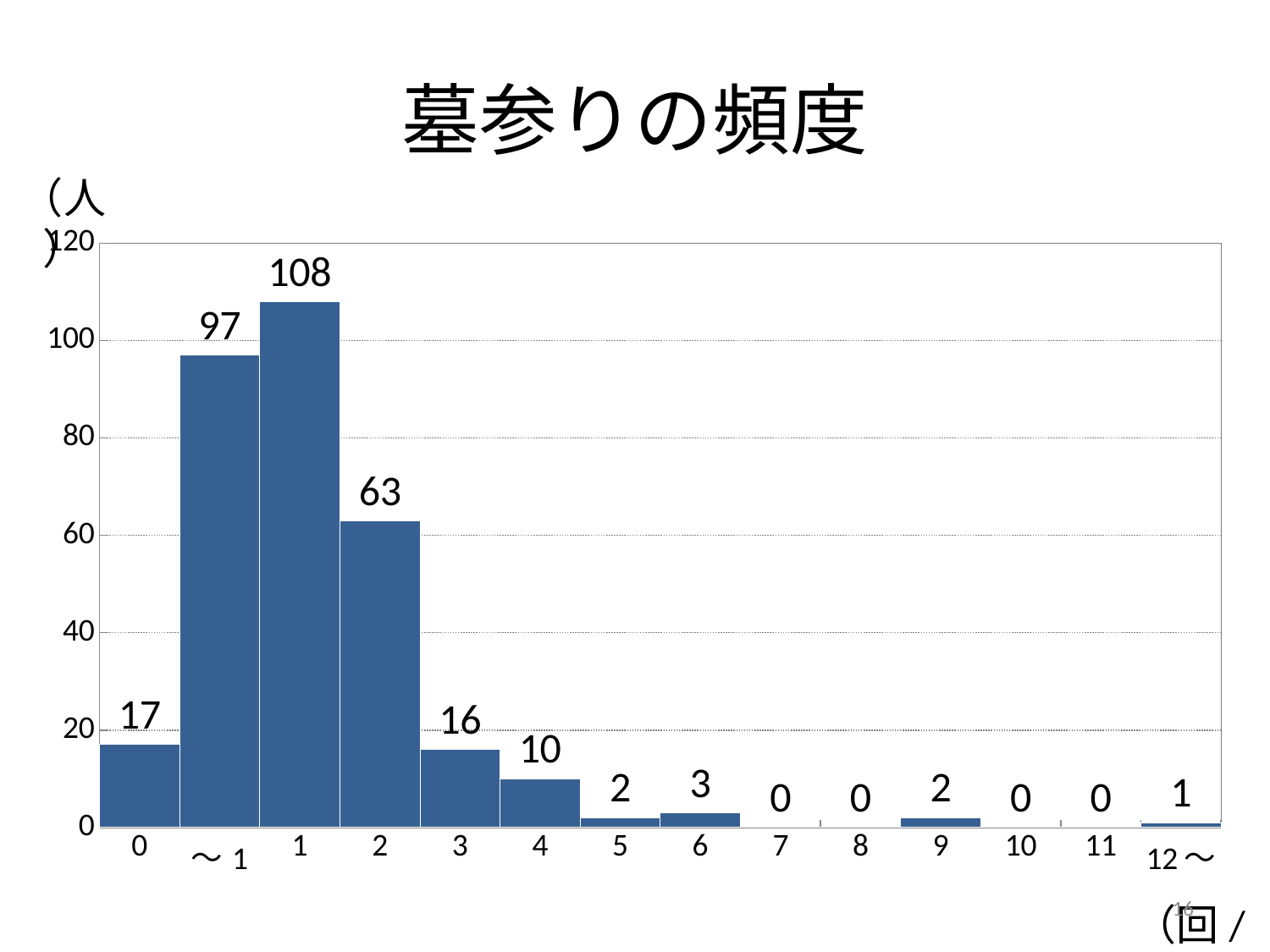
Which is larger, the value for category 3 or the value for category 4? 3 What is the value for category 1? 108 What is the value for category 0? 17 What is the difference between the values for category 1 and category 2? 45 What is the title of the chart? 墓参りの頻度 How many categories are shown on the x axis? 14 Is the value for category 2 greater or less than 60? greater What is the value for category 12〜? 1 What is the total of the values for categories 5 and 6? 5 What is the value for category 〜1? 97 What type of chart is shown on the slide? bar chart Which category has the highest value? 1